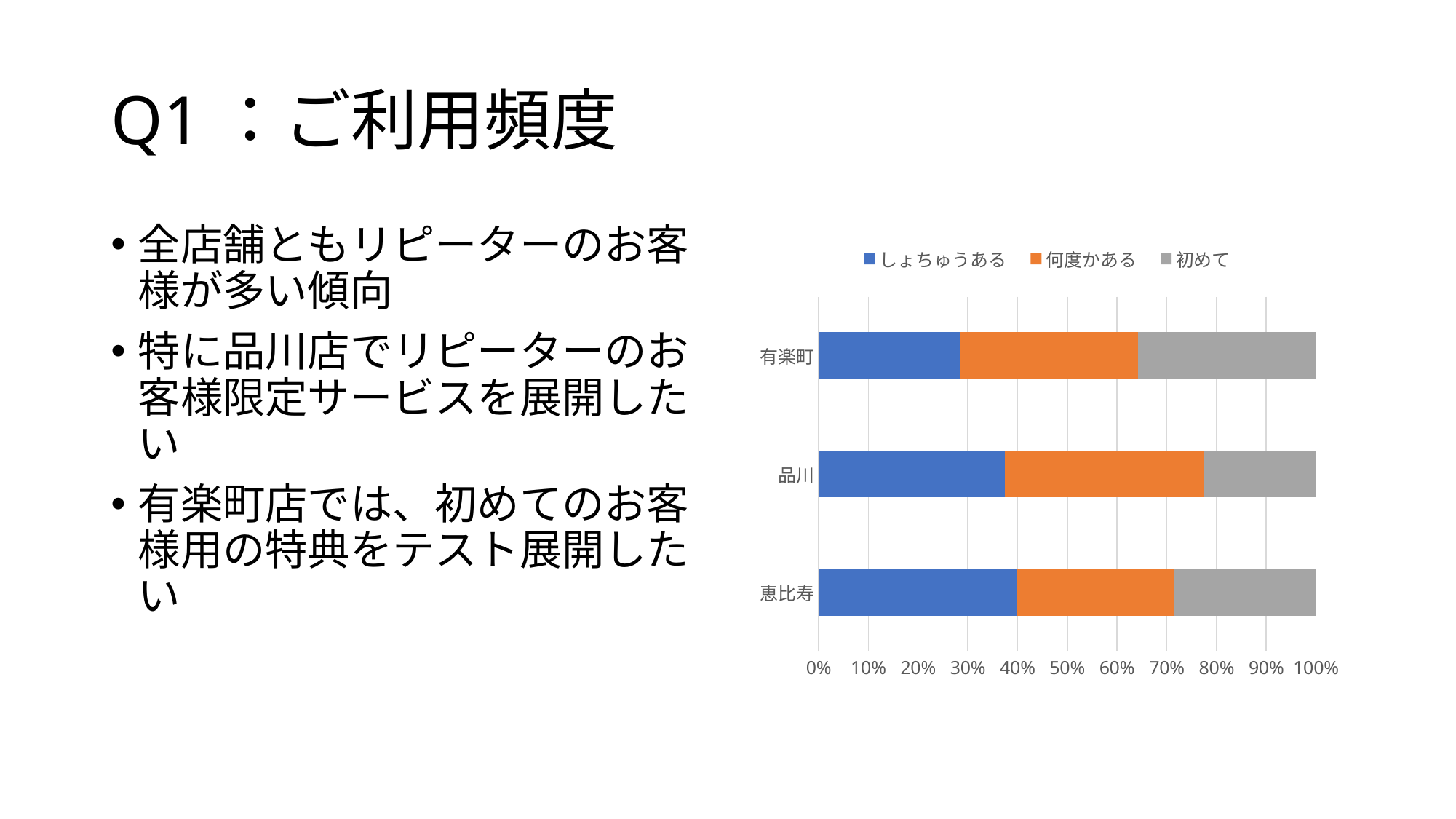
Which store has the lowest value for しょちゅうある? 有楽町 What kind of chart is shown on the slide? bar chart Is the value for 初めて at 有楽町 greater or less than 30%? greater Which store has the highest value for 初めて? 有楽町 Which is larger: the 何度かある value for 品川 or for 恵比寿? 品川 Is the value for しょちゅうある at 有楽町 greater or less than 30%? less Which series is shown in gray in the chart? 初めて Which series is listed first in the chart legend? しょちゅうある Is the value for 初めて at 品川 greater or less than 30%? less How many series does the chart legend list? 3 How many store categories are plotted on the chart? 3